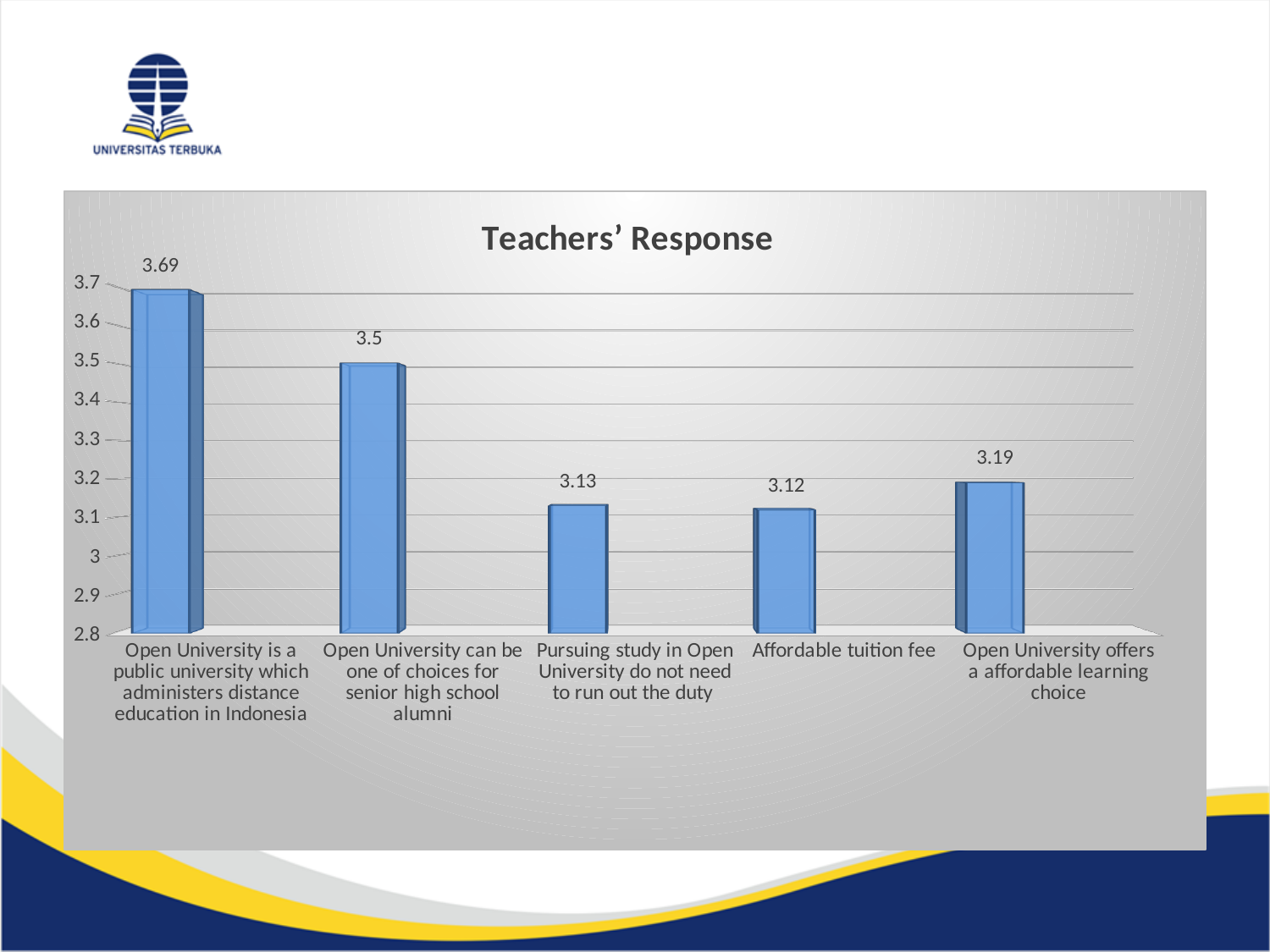
What is the difference between the values for "Open University offers a affordable learning choice" and "Affordable tuition fee"? 0.07 What is the value for "Open University can be one of choices for senior high school alumni"? 3.5 What is the difference between the values for "Open University is a public university which administers distance education in Indonesia" and "Open University can be one of choices for senior high school alumni"? 0.19 Which is larger: the value for "Open University can be one of choices for senior high school alumni" or the value for "Pursuing study in Open University do not need to run out the duty"? Open University can be one of choices for senior high school alumni Which category has the lowest value? Affordable tuition fee What is the title of the chart? Teachers' Response Is the value for "Pursuing study in Open University do not need to run out the duty" greater or less than 3.3? less What is the value for "Affordable tuition fee"? 3.12 What is the value for "Open University offers a affordable learning choice"? 3.19 What kind of chart is shown on the slide? bar chart How many categories are shown in the chart? 5 Which category has the highest value? Open University is a public university which administers distance education in Indonesia